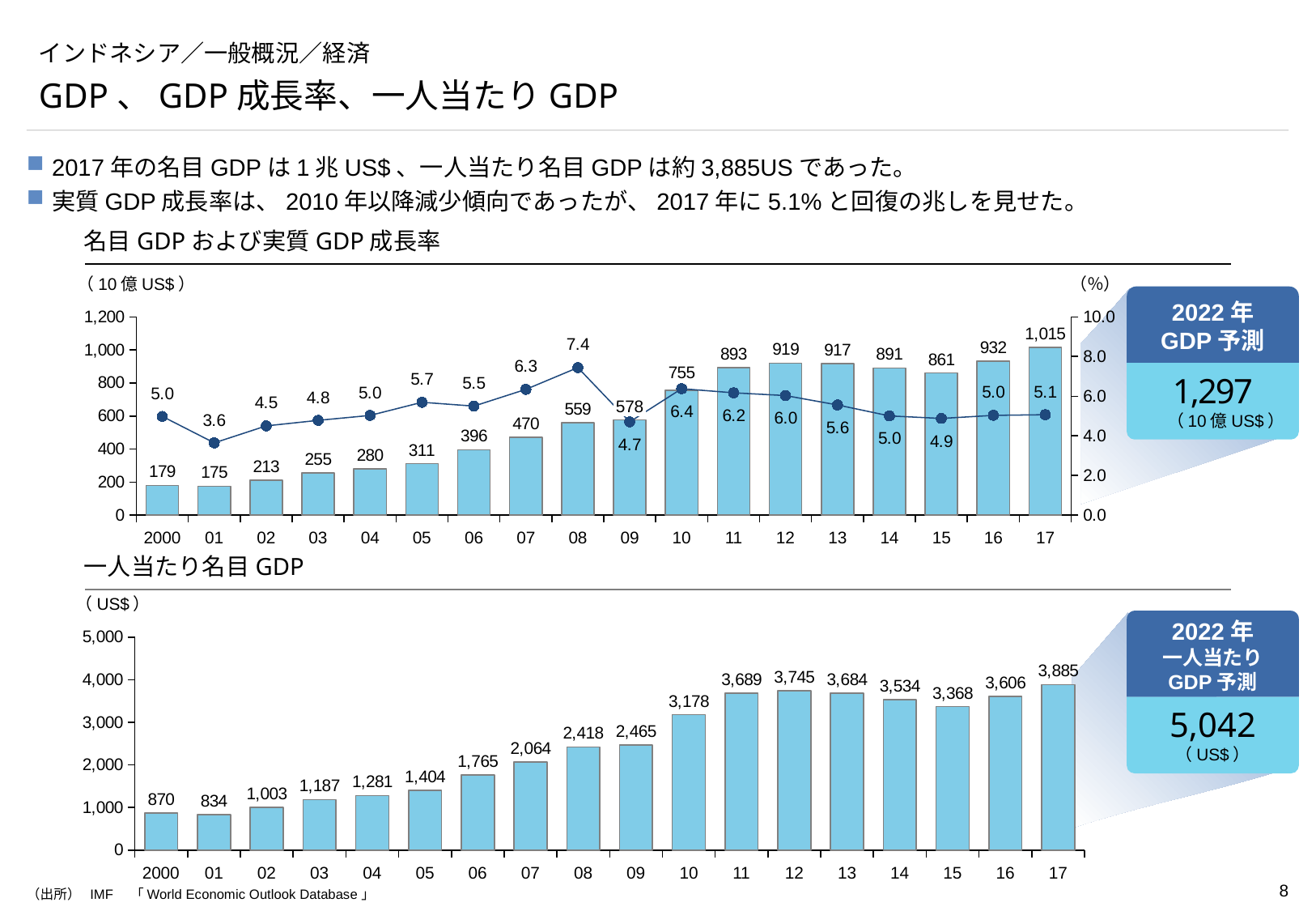
In the top chart (名目GDPおよび実質GDP成長率), what is the difference between the nominal GDP bars for 2012 and 2011? 26 In the top chart (名目GDPおよび実質GDP成長率), what is the nominal GDP bar value for 2017? 1,015 In the top chart (名目GDPおよび実質GDP成長率), is the nominal GDP bar for 2010 larger or smaller than the bar for 2009? larger In the bottom chart (一人当たり名目GDP), what is the difference between the values for 2017 and 2016? 279 In the top chart (名目GDPおよび実質GDP成長率), which year has the lowest nominal GDP bar? 01 In the top chart (名目GDPおよび実質GDP成長率), how many years are shown on the x axis? 18 In the bottom chart (一人当たり名目GDP), which year has the lowest value? 01 What kind of chart is the bottom chart (一人当たり名目GDP)? bar chart In the top chart (名目GDPおよび実質GDP成長率), which year has the highest real GDP growth rate on the line? 08 In the top chart (名目GDPおよび実質GDP成長率), what is the real GDP growth rate shown for 2008? 7.4 In the bottom chart (一人当たり名目GDP), which year has the highest value? 17 In the bottom chart (一人当たり名目GDP), what is the value for 2010? 3,178